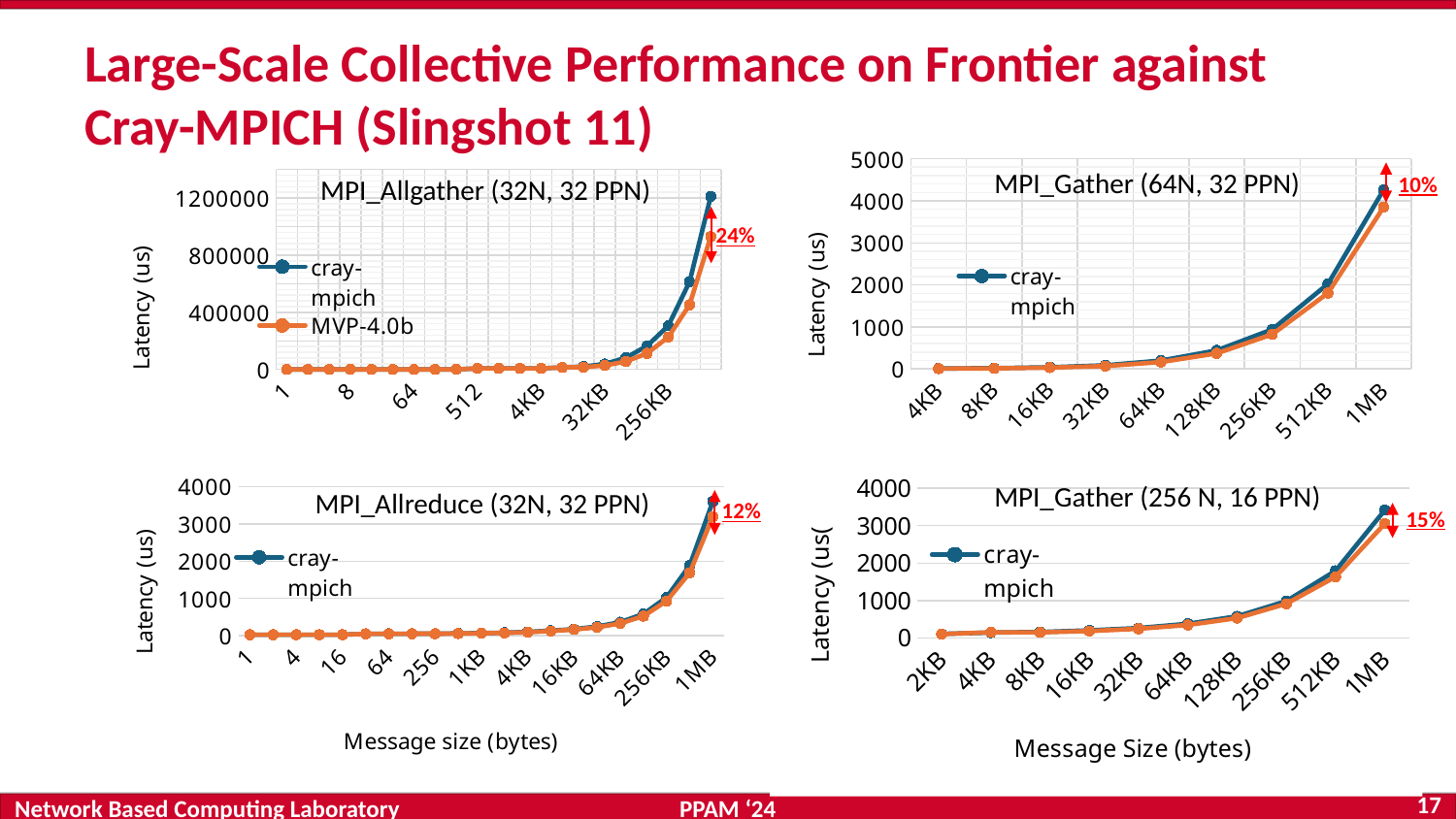
How many message sizes are plotted on the x axis of the MPI_Gather (256 N, 16 PPN) chart? 10 How many series does the legend of the MPI_Allgather (32N, 32 PPN) chart list? 2 In the MPI_Gather (64N, 32 PPN) chart, is the cray-mpich latency at 1MB greater or less than 4000? greater In the MPI_Gather (256 N, 16 PPN) chart, at which message size is latency highest? 1MB What kind of chart is MPI_Gather (64N, 32 PPN)? line chart In the MPI_Allgather (32N, 32 PPN) chart, is the cray-mpich latency at the largest message size greater or less than 800000? greater In the MPI_Allreduce (32N, 32 PPN) chart, is the cray-mpich latency at 1MB greater or less than 3000? greater In the MPI_Allreduce (32N, 32 PPN) chart, does latency rise or fall as message size increases? rises What percentage improvement is annotated on the MPI_Allgather (32N, 32 PPN) chart? 24% How many message sizes are plotted on the x axis of the MPI_Gather (64N, 32 PPN) chart? 9 In the MPI_Gather (64N, 32 PPN) chart, at which message size is latency lowest? 4KB In the MPI_Gather (64N, 32 PPN) chart, which series has the higher latency at 1MB, cray-mpich or MVP-4.0b? cray-mpich